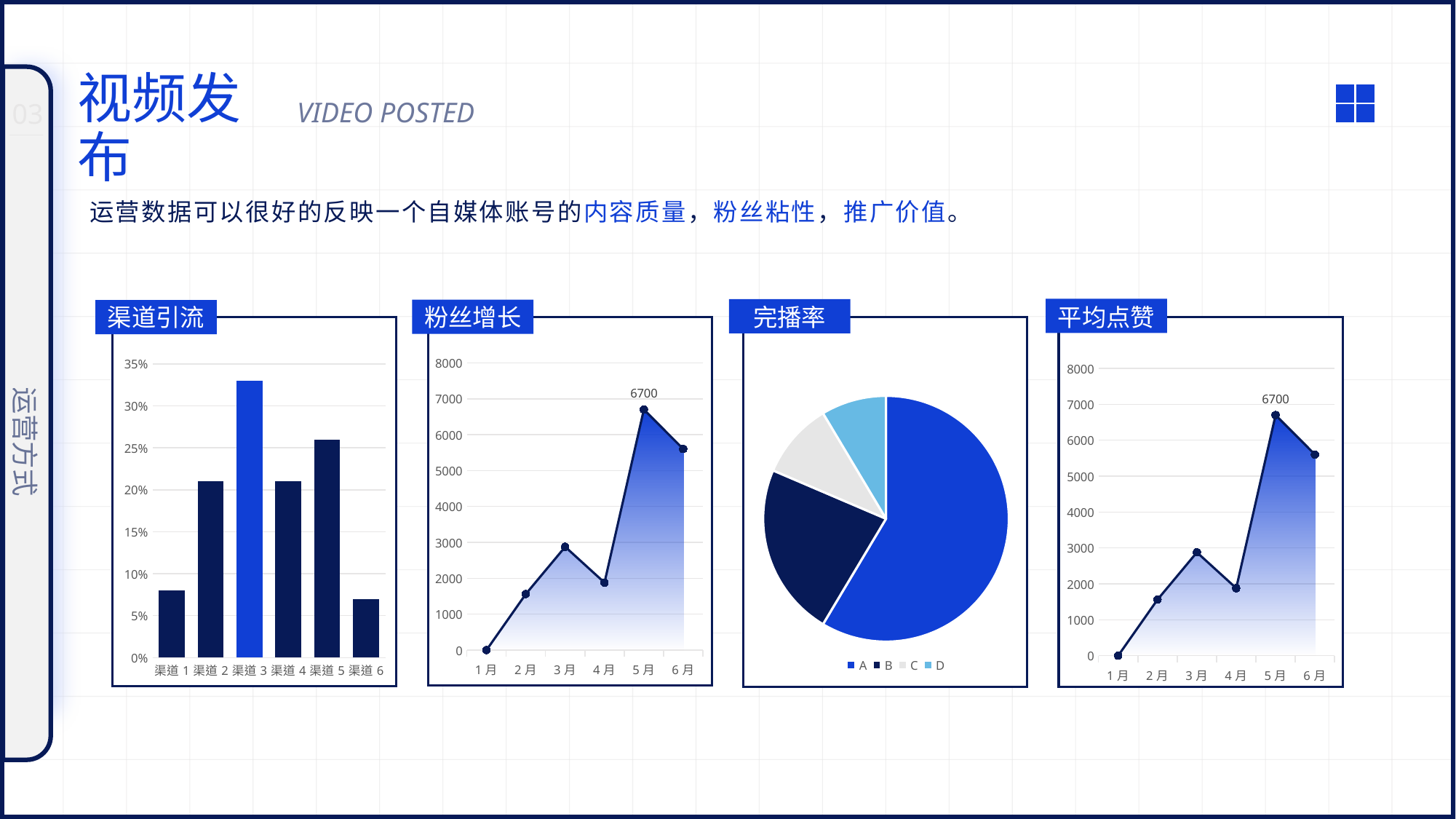
What kind of chart is the 渠道引流 chart? bar chart How many channels are shown in the 渠道引流 chart? 6 In the 完播率 chart, how many series does the legend list? 4 In the 渠道引流 chart, which channel has the lowest value? 渠道 6 In the 粉丝增长 chart, which month has the highest value? 5月 In the 平均点赞 chart, what is the value for 5月? 6700 In the 粉丝增长 chart, is the value for 6月 greater or less than 6000? less In the 完播率 chart, which slice is the largest? A In the 渠道引流 chart, is the value for 渠道 3 greater or less than 30%? greater In the 粉丝增长 chart, what is the value for 5月? 6700 In the 渠道引流 chart, is the value for 渠道 1 greater or less than 10%? less In the 渠道引流 chart, which channel has the highest value? 渠道 3